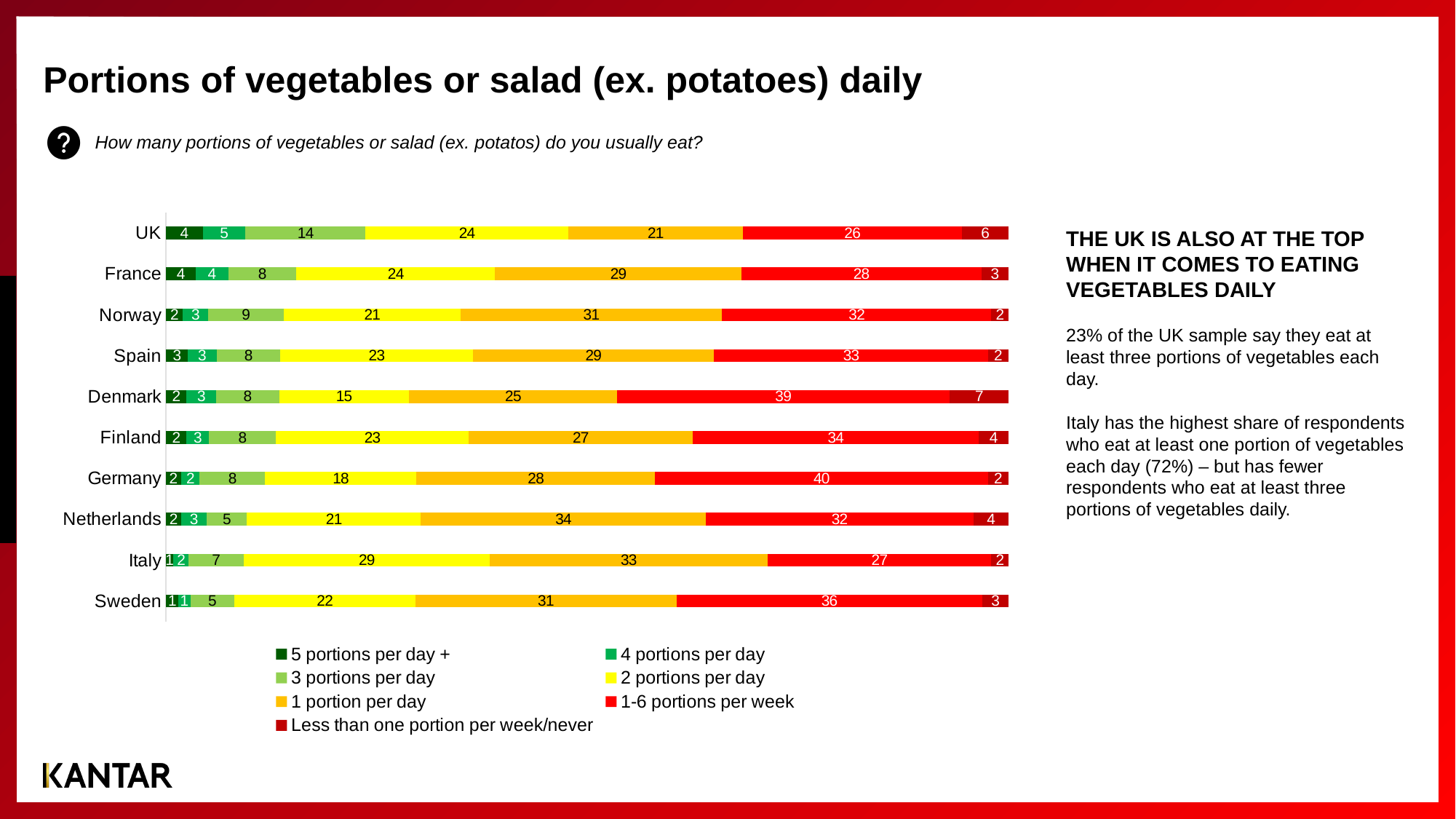
Which country has the highest value for '3 portions per day'? UK What is the difference between the '1-6 portions per week' values for Denmark and Italy? 12 How many series does the legend list? 7 What kind of chart is shown on the slide? Stacked bar chart Which country has the highest value for '1-6 portions per week'? Germany Which country has the lowest value for '2 portions per day'? Denmark Which is larger: the '1 portion per day' value for Italy or for France? Italy What is the value for '1-6 portions per week' for Germany? 40 What is the value for '1 portion per day' for the Netherlands? 34 What is the value for '3 portions per day' for Norway? 9 How many countries are shown in the chart? 10 What is the value for '2 portions per day' for the UK? 24